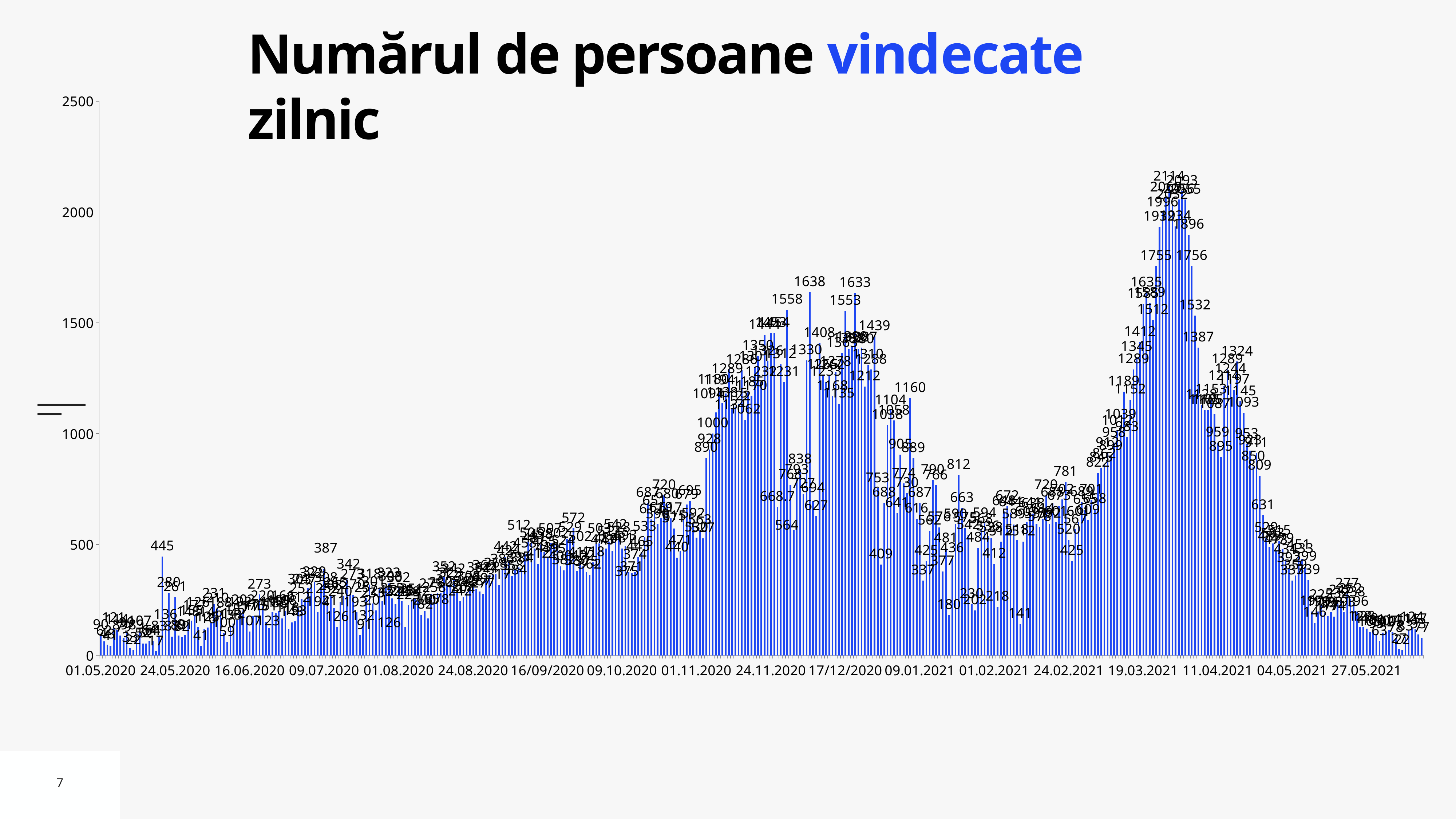
What is the highest value labelled on the chart? 2114 What is the title of the chart? Numărul de persoane vindecate zilnic What kind of chart is shown on the slide? bar chart What is the value of the tallest bar between 01.05.2020 and 16.06.2020? 445 How many data series are plotted on the chart? 1 Is the value at 01.02.2021 greater or less than 500? less Do the values rise or fall between 11.04.2021 and 27.05.2021? fall Which peak is higher, the one in late 2020 or the one in spring 2021? spring 2021 What is the difference between the overall peak value (2114) and the late-2020 peak value (1638)? 476 What is the highest value shown on the vertical axis? 2500 What is the value of the tallest bar between 24.11.2020 and 17/12/2020? 1638 Is the tallest bar on the chart greater or less than 2000? greater